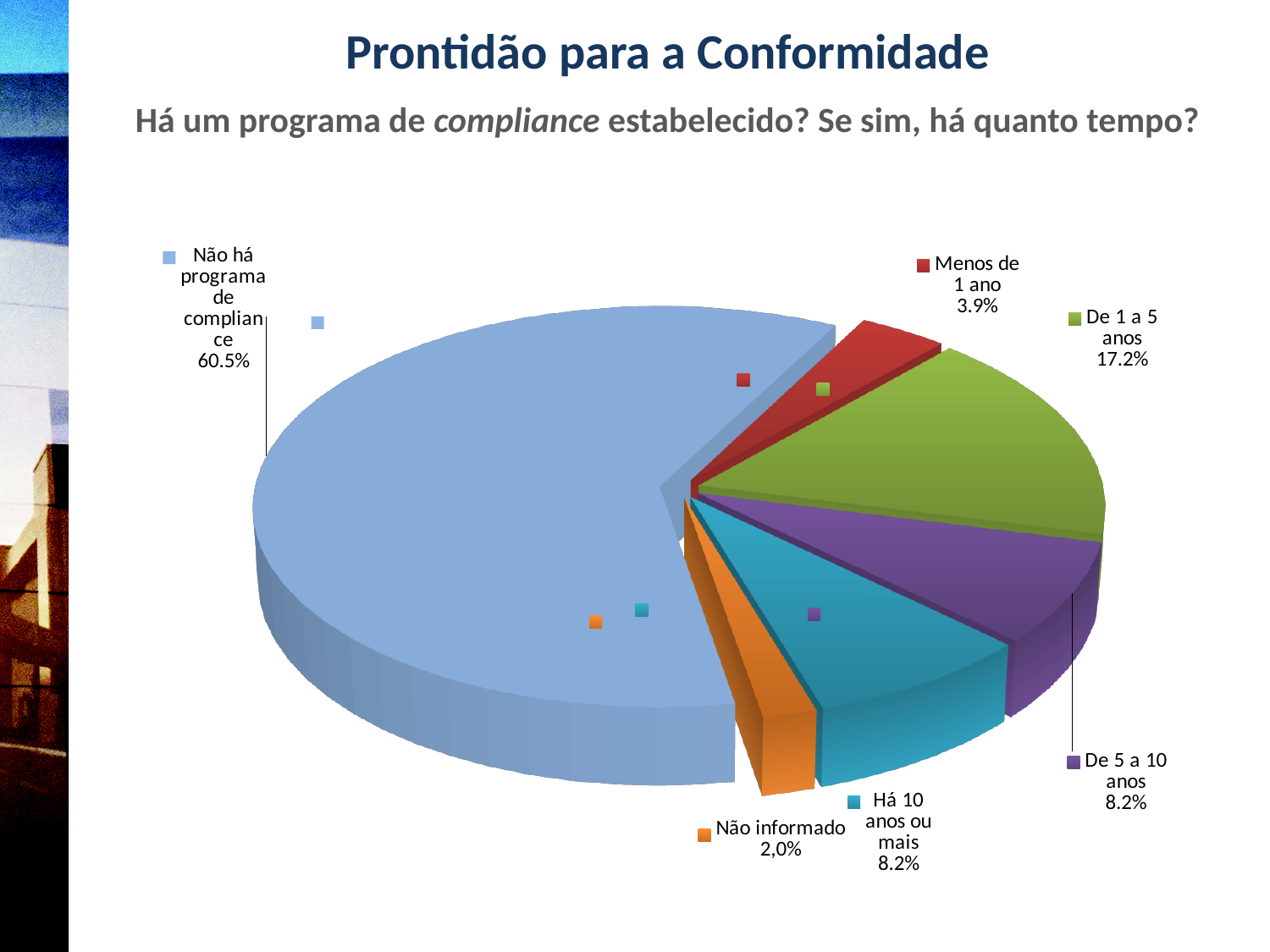
What percentage of respondents have no compliance program (Não há programa de compliance)? 60.5% How many categories (slices) does the pie chart have? 6 What is the difference between 'Não há programa de compliance' and 'De 1 a 5 anos'? 43.3% What is the difference between 'De 5 a 10 anos' and 'Menos de 1 ano'? 4.3% What is the value for 'De 1 a 5 anos'? 17.2% What type of chart is shown on the slide? pie chart What is the value for 'Menos de 1 ano'? 3.9% Which category has the smallest slice of the pie? Não informado Which category has the largest slice of the pie? Não há programa de compliance What is the value for 'Não informado'? 2,0% Which is larger, 'De 1 a 5 anos' or 'Menos de 1 ano'? De 1 a 5 anos What is the value for 'Há 10 anos ou mais'? 8.2%